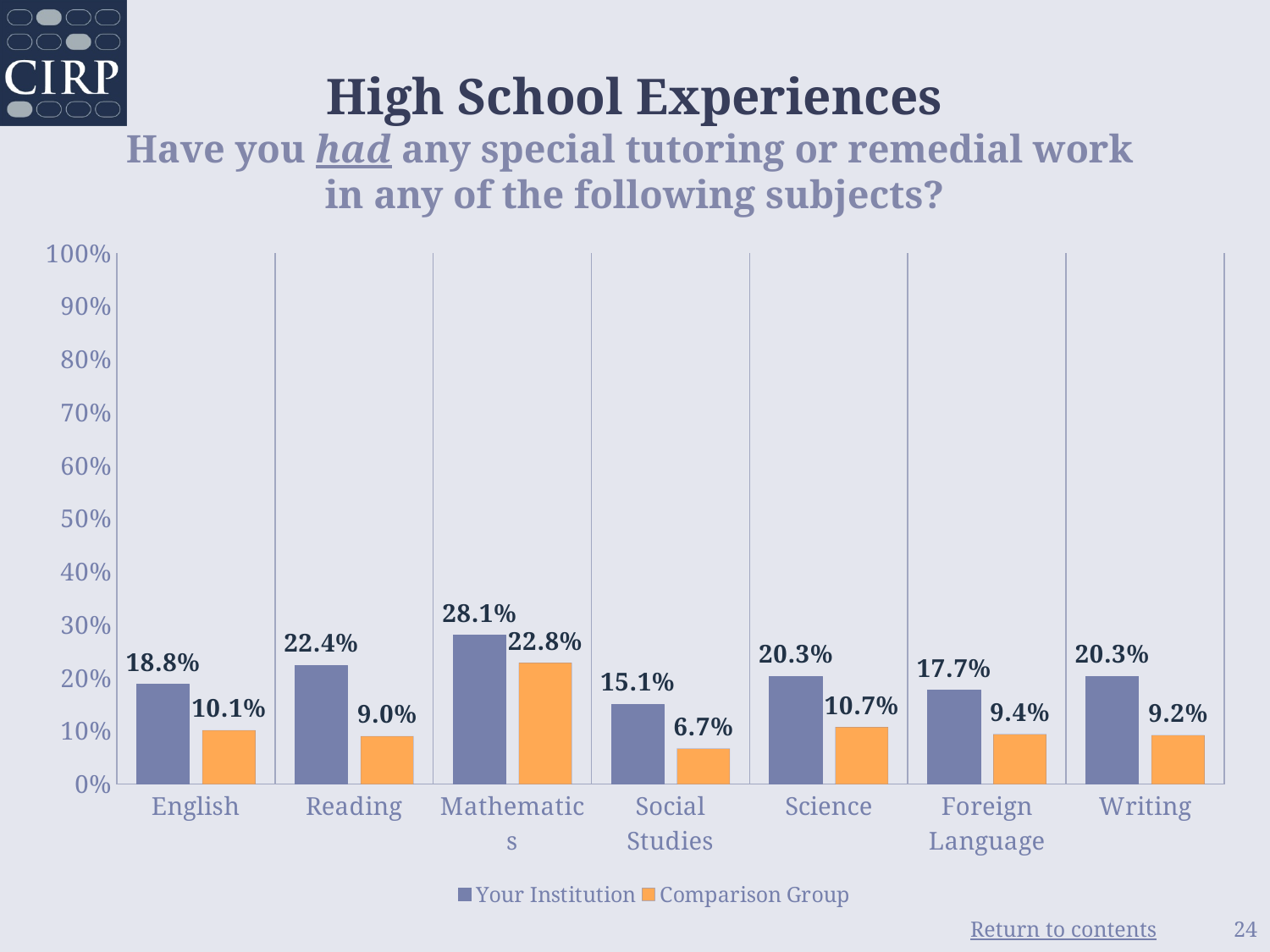
What is the value for Comparison Group in Social Studies? 6.7% Is the value for Your Institution in Science greater or less than 30%? less What is the value for Your Institution in Foreign Language? 17.7% What kind of chart is shown on the slide? bar chart Which subject has the lowest value for Comparison Group? Social Studies Which is larger in English: Your Institution or Comparison Group? Your Institution Which subject has the highest value for Your Institution? Mathematics How many subjects are shown on the x axis? 7 What colour are the Comparison Group bars? orange What is the difference between Your Institution and Comparison Group in Reading? 13.4% How many series does the legend list? 2 What is the value for Your Institution in Mathematics? 28.1%